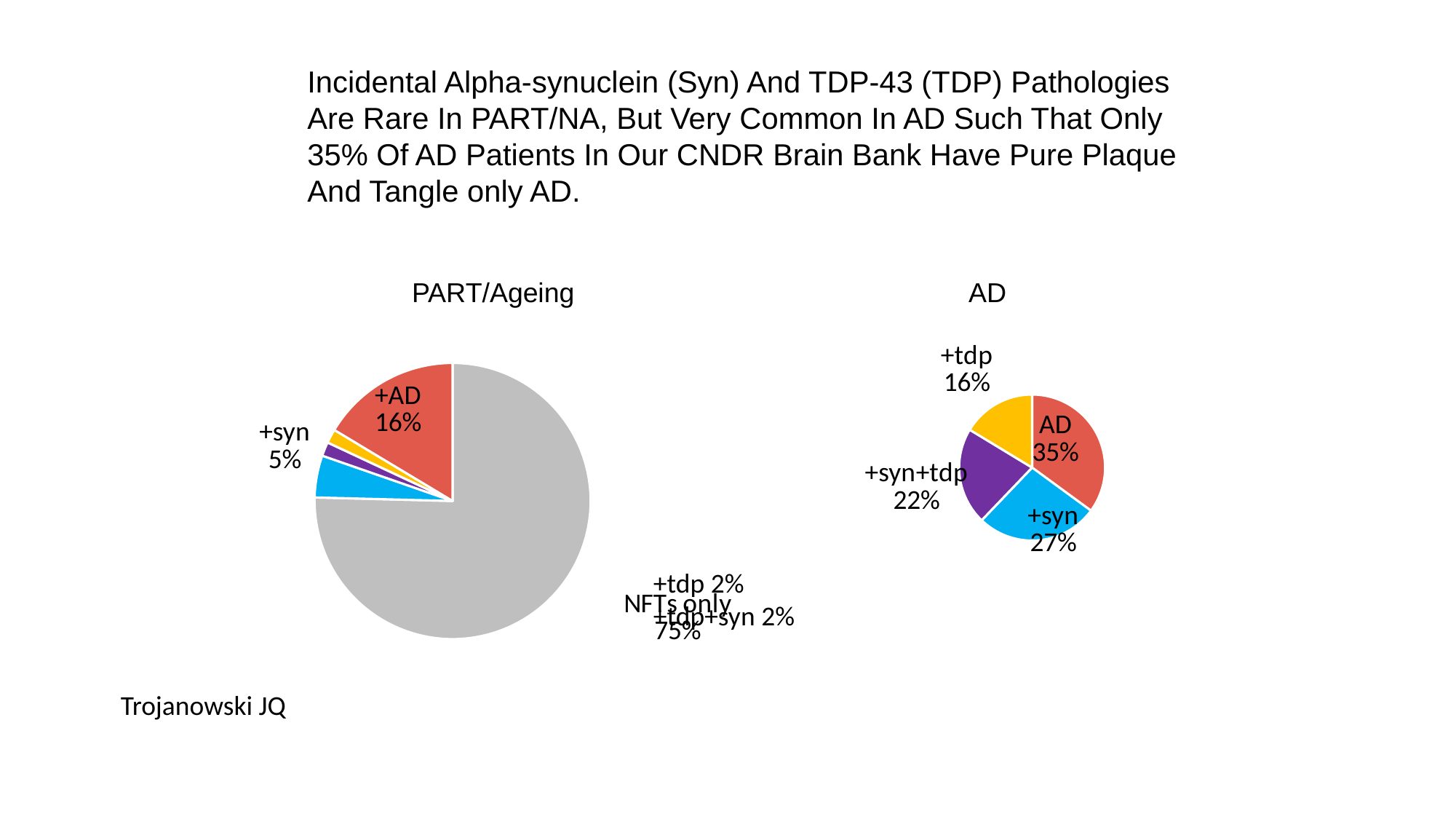
In the PART/Ageing chart, what percentage is labelled +AD? 16% In the AD chart, what percentage is labelled +syn+tdp? 22% In the PART/Ageing chart, what share of the pie is NFTs only? 75% In the PART/Ageing chart, which slice is the largest? NFTs only In the PART/Ageing chart, what percentage is labelled +syn? 5% What kind of chart is used for the AD data? Pie chart In the AD chart, which is larger, +syn or +syn+tdp? +syn In the AD chart, which slice is the largest? AD In the AD chart, which slice is the smallest? +tdp In the AD chart, what is the difference between the +syn slice and the +tdp slice? 11% In the AD chart, what percentage is labelled AD? 35% In the AD chart, what percentage is labelled +tdp? 16%